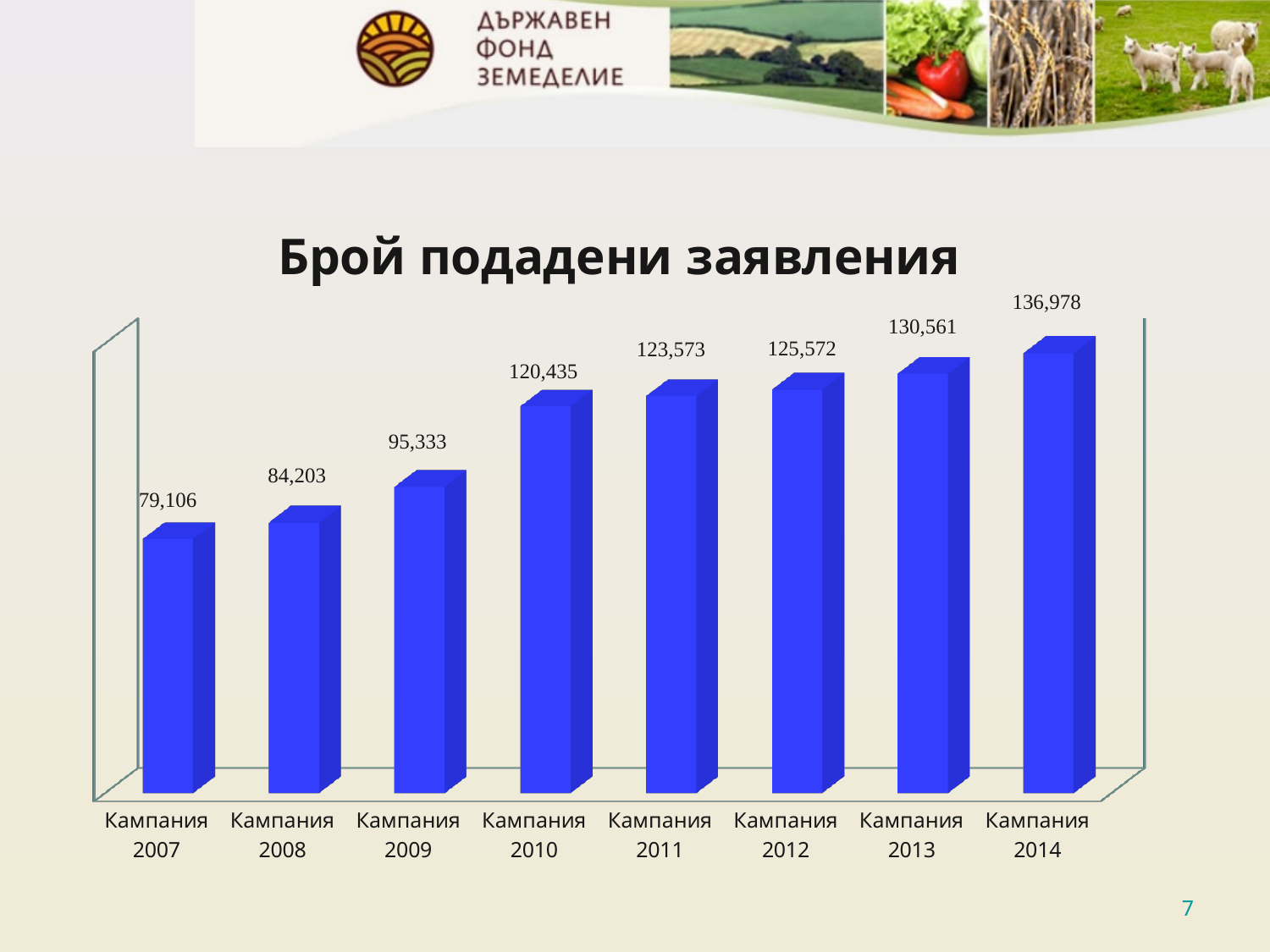
How many campaigns are shown in the chart? 8 Which is larger, the value for Кампания 2011 or Кампания 2012? Кампания 2012 What is the difference between the values for Кампания 2010 and Кампания 2009? 25,102 What is the title of the chart? Брой подадени заявления What kind of chart is shown on the slide? Bar chart Which campaign has the lowest number of submitted applications? Кампания 2007 Do the values rise or fall from Кампания 2007 to Кампания 2014? Rise What is the difference between the values for Кампания 2014 and Кампания 2007? 57,872 Which campaign has the highest number of submitted applications? Кампания 2014 What is the value for Кампания 2010? 120,435 What is the value for Кампания 2013? 130,561 What is the value for Кампания 2007? 79,106